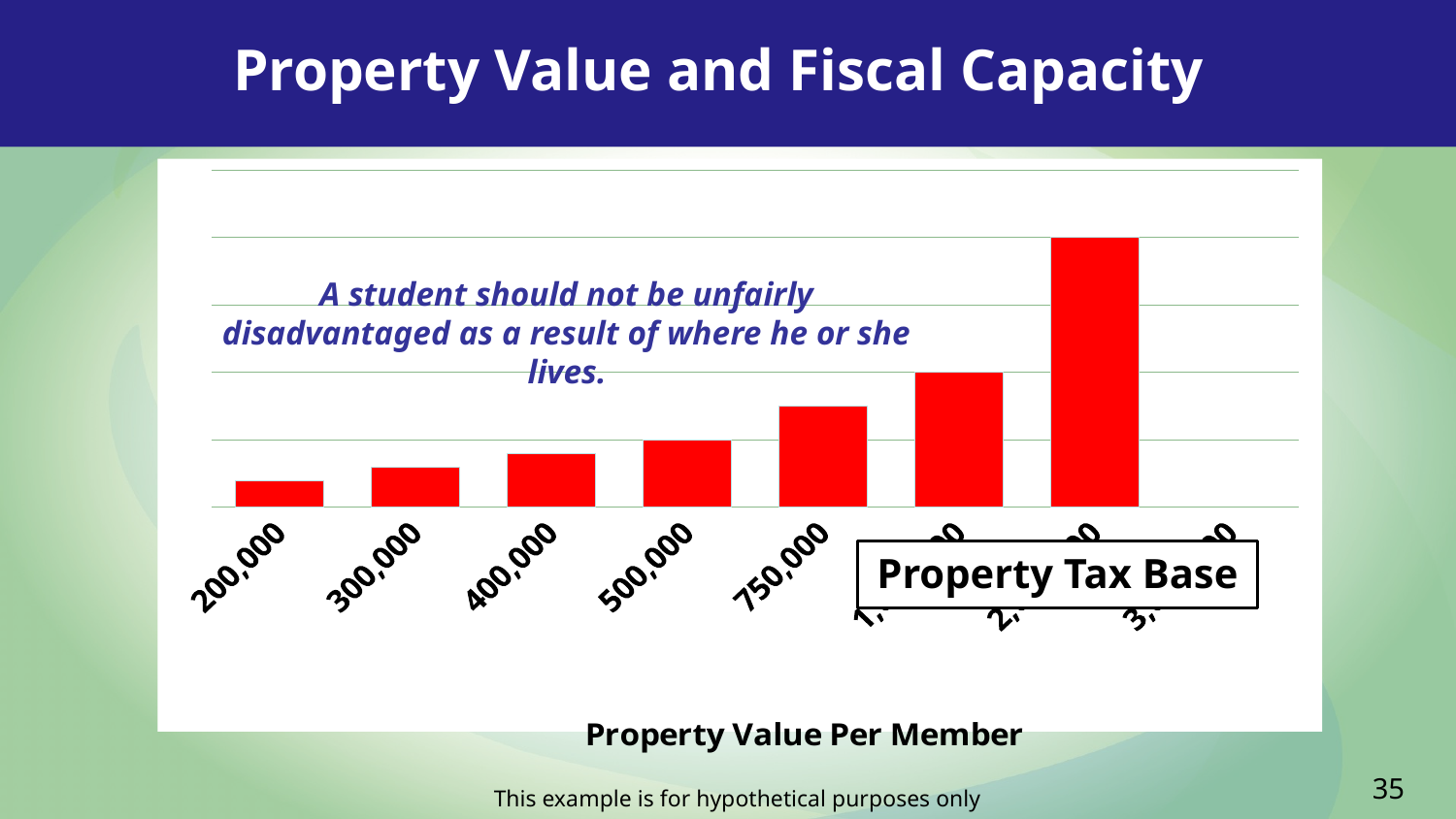
Which bar is shorter, the one for 200,000 or the one for 400,000? 200,000 What is the x-axis title of the chart? Property Value Per Member Where is the tallest bar located in the chart? the rightmost bar What kind of chart is shown on the slide? bar chart Which bar is taller, the one for 400,000 or the one for 500,000? 500,000 How many bars are plotted in the chart? 7 Which category has the lowest bar in the chart? 200,000 Which bar is taller, the one for 750,000 or the one for 300,000? 750,000 Do the bar heights rise or fall as property value per member increases along the x axis? rise What colour are the bars in the chart? red